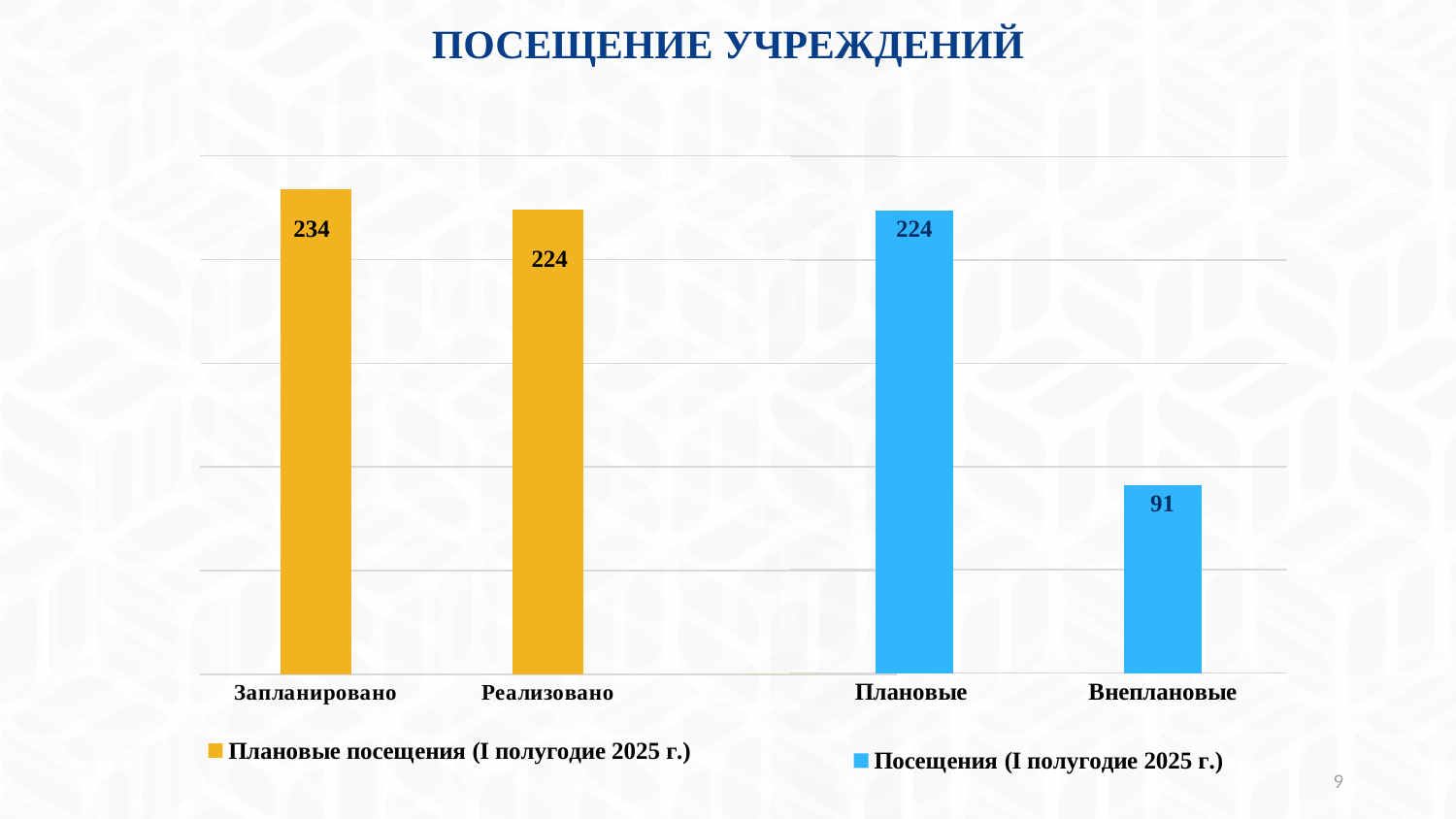
In the left chart, what is the difference between Запланировано and Реализовано? 10 In the right chart, which category has the lowest value? Внеплановые In the left chart, what is the value for Реализовано? 224 In the left chart, which category has the higher value? Запланировано In the right chart, what is the difference between Плановые and Внеплановые? 133 In the left chart, what is the value for Запланировано? 234 In the right chart, what is the value for Внеплановые? 91 What is the legend entry of the right chart? Посещения (I полугодие 2025 г.) In the right chart, is the value for Плановые larger or smaller than the value for Внеплановые? larger How many categories are shown in the right chart? 2 In the right chart, what is the value for Плановые? 224 What type of chart is the left chart? bar chart